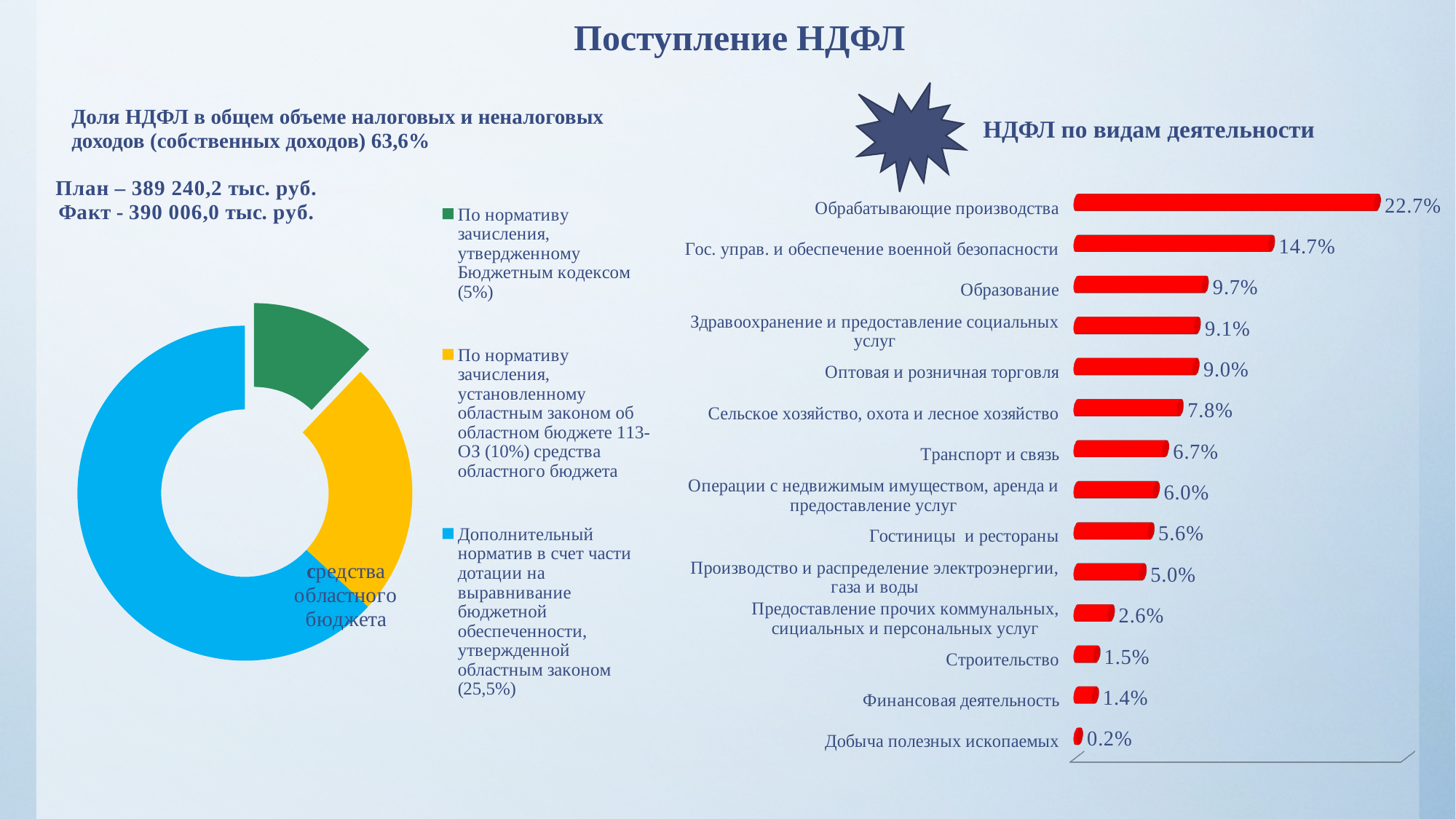
On the chart titled 'НДФЛ по видам деятельности', what is the difference between the values for Обрабатывающие производства and Гос. управ. и обеспечение военной безопасности? 8.0% On the chart titled 'НДФЛ по видам деятельности', what is the value for Образование? 9.7% On the chart titled 'НДФЛ по видам деятельности', which is larger: the value for Строительство or the value for Финансовая деятельность? Строительство On the chart titled 'НДФЛ по видам деятельности', how many categories are shown? 14 On the chart titled 'НДФЛ по видам деятельности', do the values increase or decrease going from the top bar to the bottom bar? Decrease On the chart titled 'НДФЛ по видам деятельности', what is the value for Гостиницы и рестораны? 5.6% On the chart titled 'НДФЛ по видам деятельности', which category has the highest value? Обрабатывающие производства What kind of chart is the chart on the left side of the slide? Doughnut chart On the chart titled 'НДФЛ по видам деятельности', which category has the lowest value? Добыча полезных ископаемых How many entries does the legend of the doughnut chart on the left list? 3 What kind of chart is the chart titled 'НДФЛ по видам деятельности'? Bar chart On the chart titled 'НДФЛ по видам деятельности', what is the value for Транспорт и связь? 6.7%